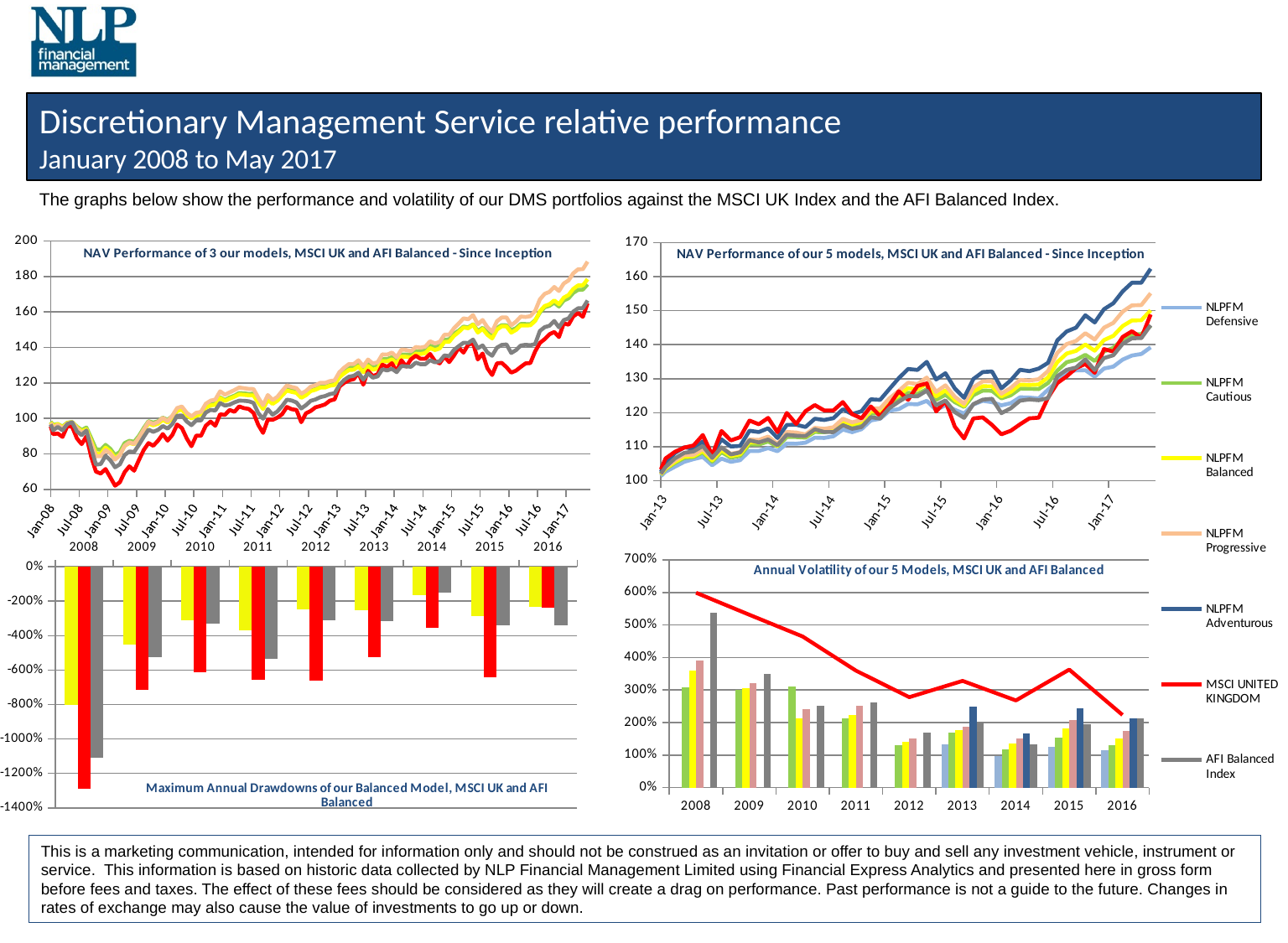
In the 'Annual Volatility of our 5 Models' chart, is the AFI Balanced Index value for 2008 greater or less than 500%? greater In the 'NAV Performance of 3 our models' chart, is the MSCI UK value at Jan-09 greater or less than 80? less In the 'Maximum Annual Drawdowns' chart, is the MSCI UK value for 2008 greater or less than -1200%? less In the 'Maximum Annual Drawdowns of our Balanced Model, MSCI UK and AFI Balanced' chart, how many years are shown on the x axis? 9 In the 'Annual Volatility of our 5 Models' chart, in which year does the MSCI UK line reach its highest value? 2008 What kind of chart is the 'NAV Performance of 3 our models, MSCI UK and AFI Balanced - Since Inception' chart? Line chart In the 'Annual Volatility of our 5 Models' chart, does the MSCI UK line rise or fall from 2008 to 2012? Fall What kind of chart is the 'Annual Volatility of our 5 Models, MSCI UK and AFI Balanced' chart? Bar and line chart In the 'Maximum Annual Drawdowns' chart, in which year is the MSCI UK drawdown the largest (the bar extends furthest below zero)? 2008 How many series does the legend on the right of the slide list? 7 In the 'NAV Performance of our 5 models' chart, which series has the highest value at the end of the period (2017)? NLPFM Adventurous